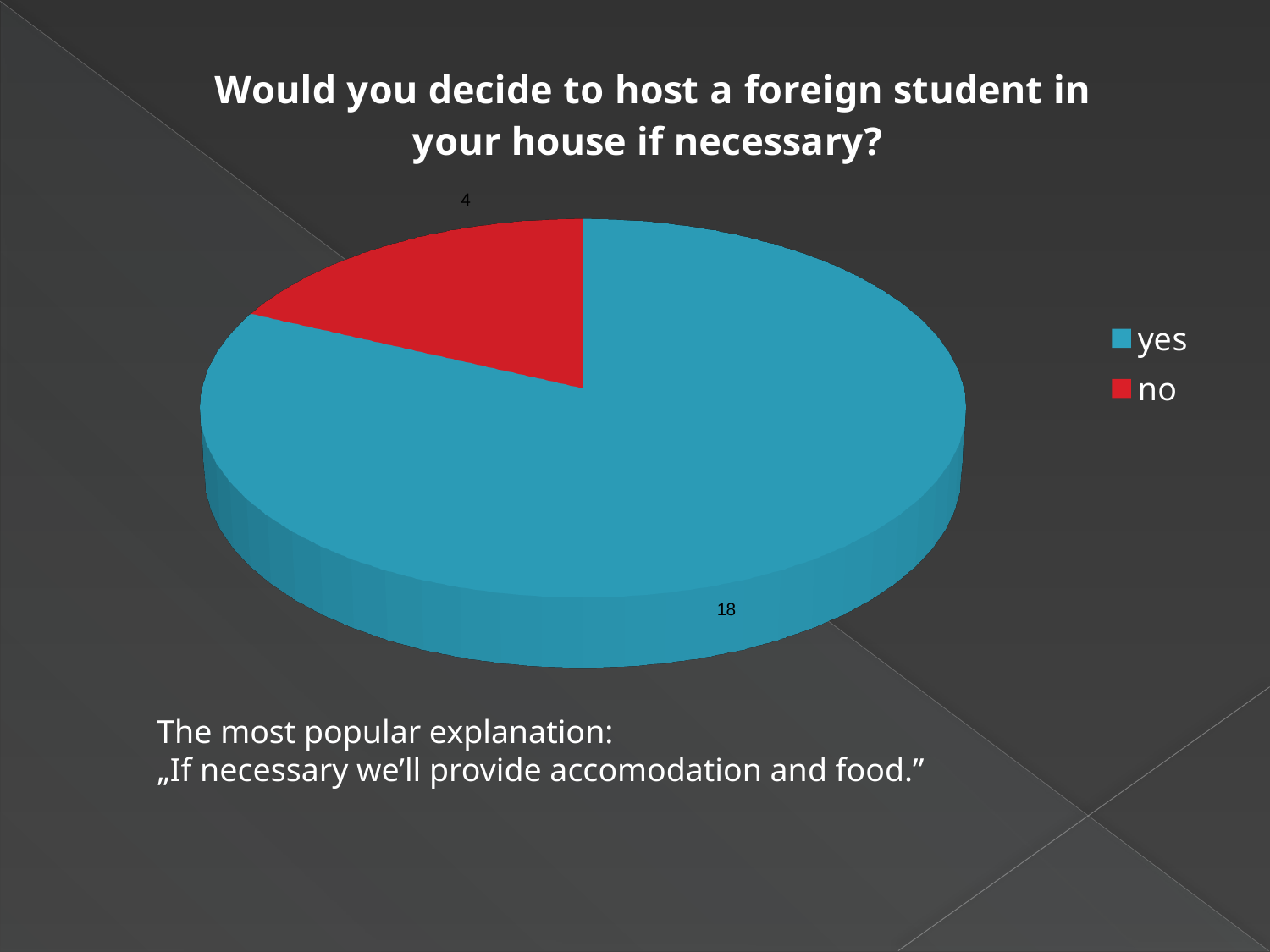
How many more people answered "yes" than "no"? 14 How many people answered "yes"? 18 Which answer has the largest slice of the pie? yes How many categories does the pie chart have? 2 What is the total of all slices in the pie chart? 22 What kind of chart is shown on the slide? pie chart What is the title of the chart? Would you decide to host a foreign student in your house if necessary? Which is larger, the value for "yes" or the value for "no"? yes What colour is the "no" slice? red Which answer has the smallest slice of the pie? no How many entries does the legend list? 2 How many people answered "no"? 4